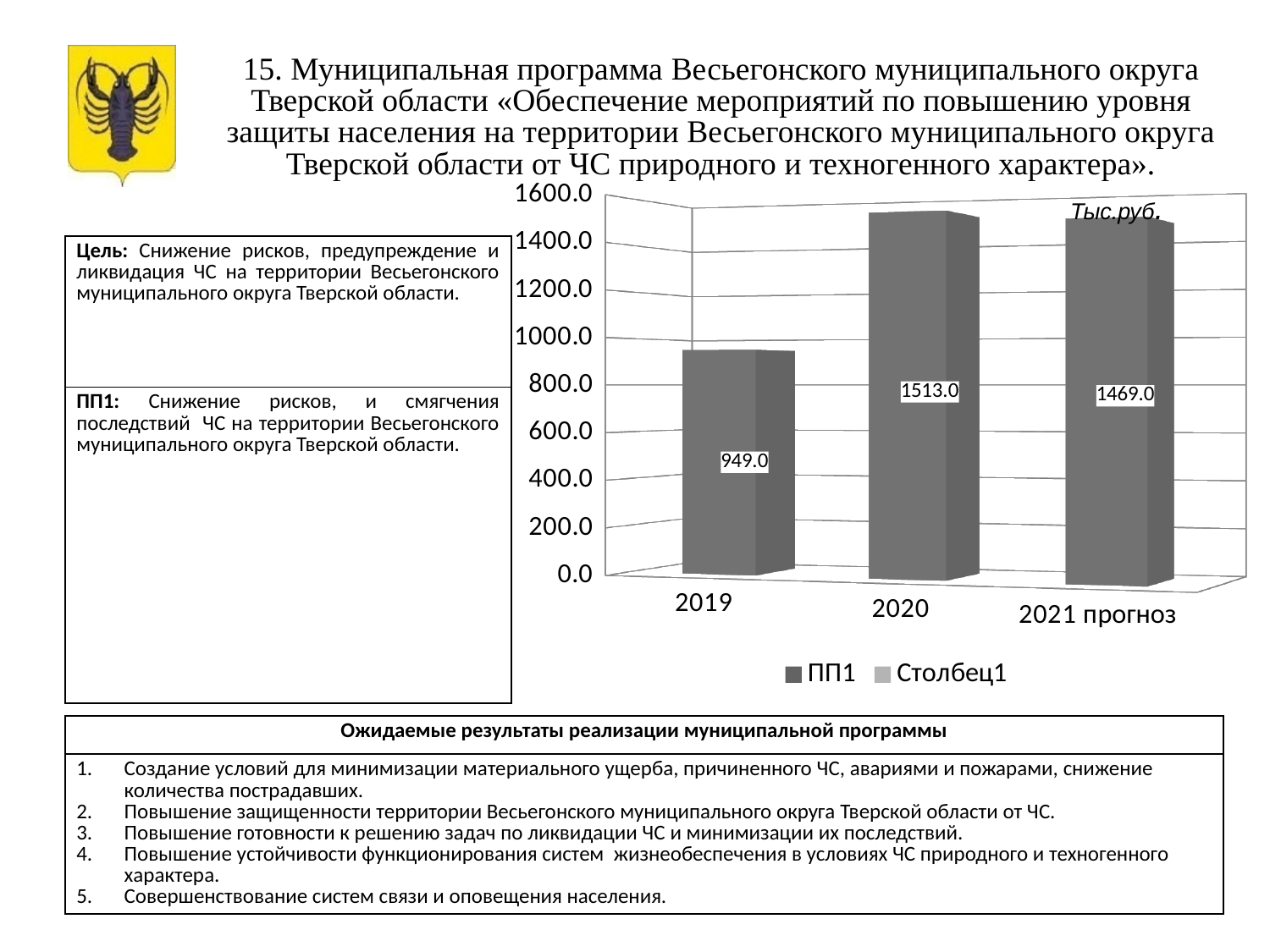
What is the difference between the values for 2020 and 2021 прогноз? 44.0 Which is larger, the value for 2019 or the value for 2021 прогноз? 2021 прогноз What is the difference between the values for 2020 and 2019? 564.0 What is the value for 2020 on the chart? 1513.0 What type of chart is shown on the slide? bar chart How many categories are shown on the x axis of the chart? 3 Is the value for 2019 greater or less than 1000.0? less What is the value for 2021 прогноз on the chart? 1469.0 Which year has the highest value on the chart? 2020 Which year has the lowest value on the chart? 2019 What is the value for 2019 on the chart? 949.0 How many series does the chart legend list? 2